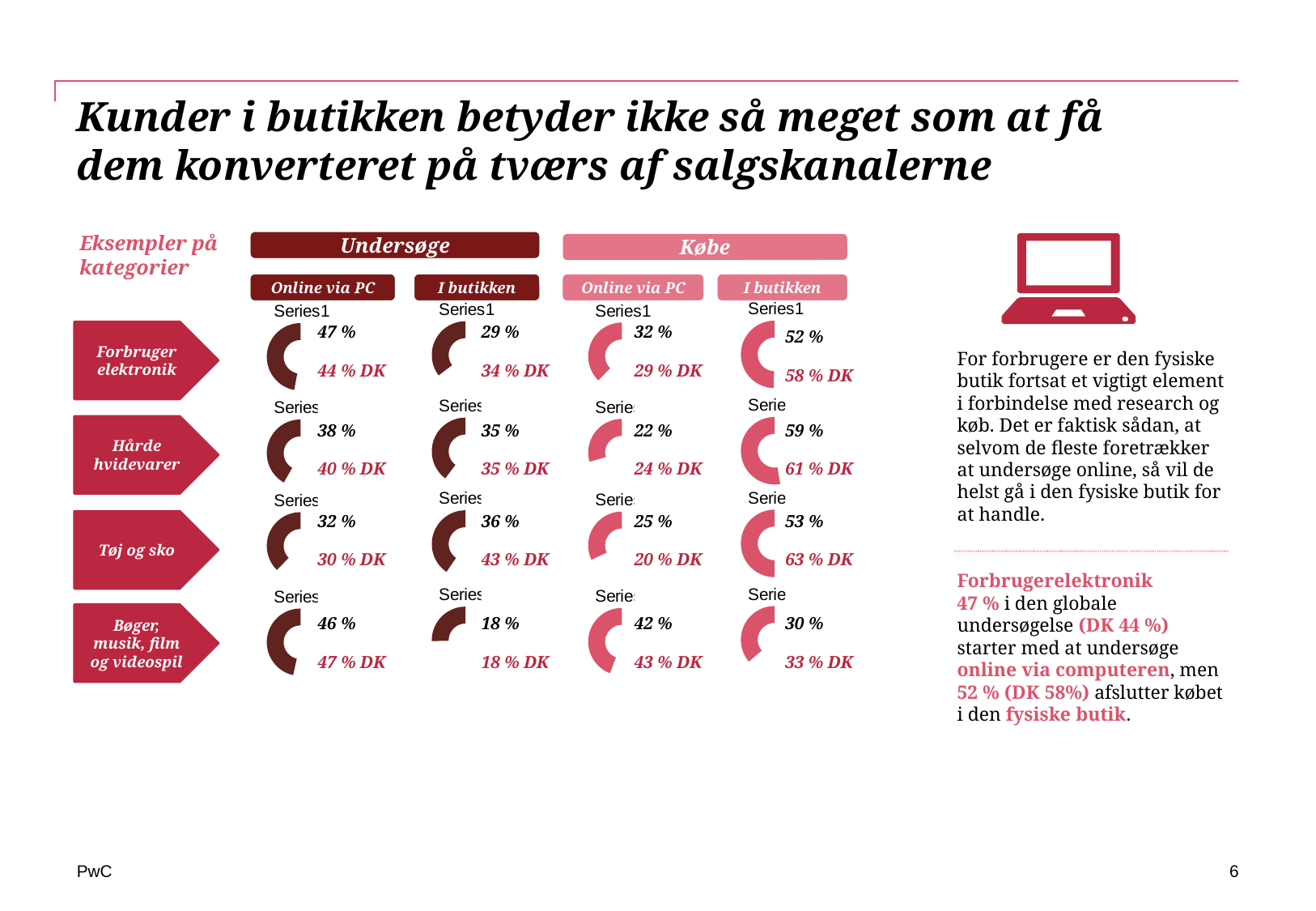
In the Købe / I butikken column, what value is shown for Hårde hvidevarer? 59 % What are the two main column headings above the chart grid? Undersøge and Købe In the Undersøge / I butikken column, which category has the lowest value? Bøger, musik, film og videospil What is the DK value for Bøger, musik, film og videospil in the Undersøge / Online via PC column? 47 % DK In the Undersøge / I butikken column, what value is shown for Bøger, musik, film og videospil? 18 % In the Købe / Online via PC column, what DK value is shown for Tøj og sko? 20 % DK In the Undersøge / Online via PC column, what value is shown for Forbruger elektronik? 47 % For Hårde hvidevarer, which is larger: the Undersøge / Online via PC value or the Undersøge / I butikken value? Undersøge / Online via PC What kind of chart is used to show each percentage in the grid? Doughnut chart How many category rows are shown in the chart grid? 4 For Forbruger elektronik, what is the difference between the Købe / I butikken value (52 %) and the Købe / Online via PC value (32 %)? 20 % In the Købe / I butikken column, which category has the highest value? Hårde hvidevarer